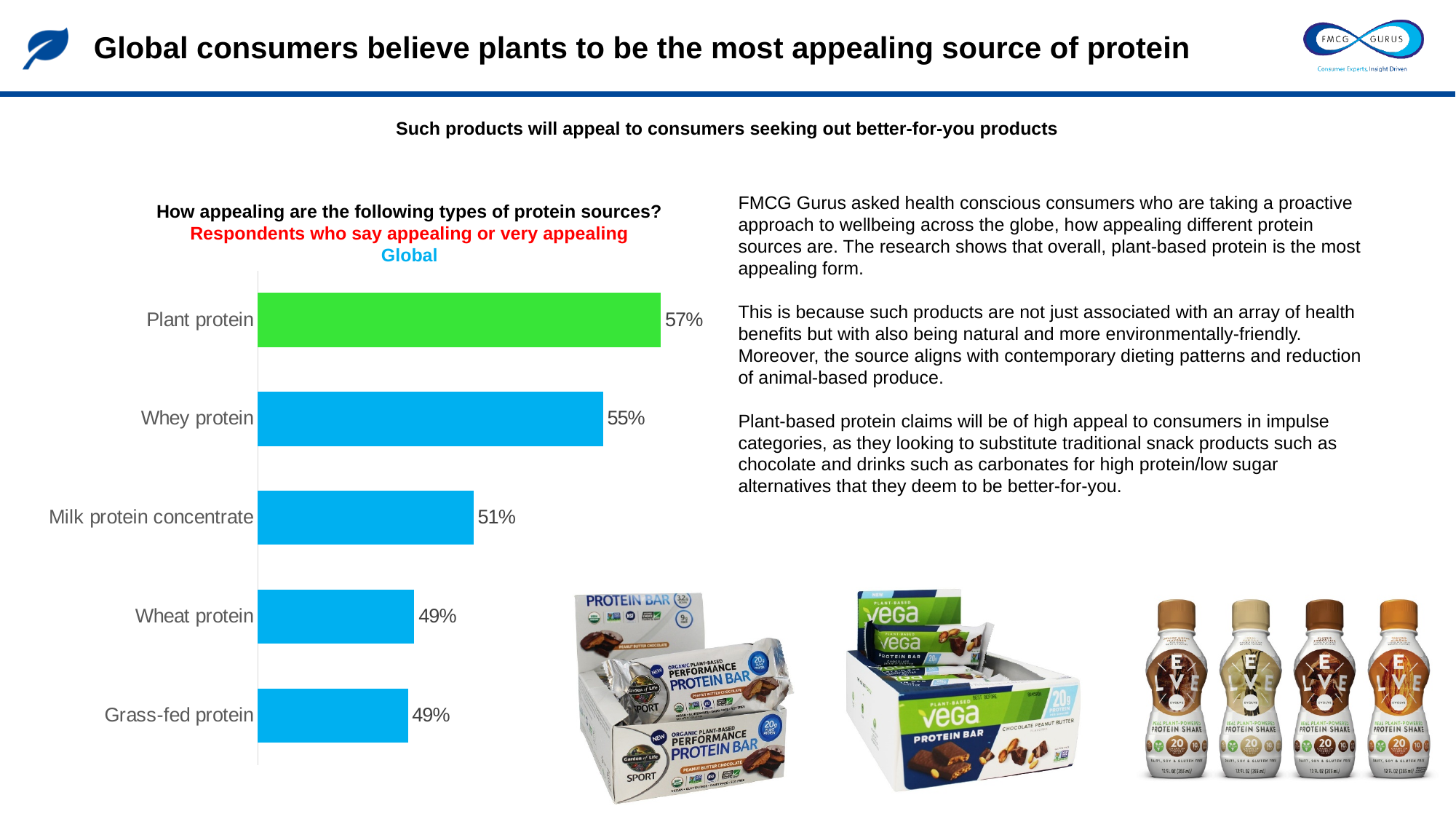
What is the value shown for wheat protein? 49% Which two protein sources share the same value of 49%? Wheat protein and grass-fed protein Which protein source has the highest share of respondents saying appealing or very appealing? Plant protein Which bar in the chart is coloured green rather than blue? Plant protein What percentage of respondents say plant protein is appealing or very appealing? 57% Which has a higher value, whey protein or milk protein concentrate? Whey protein What is the difference in percentage points between plant protein and whey protein? 2 percentage points What type of chart is used to show the appeal of protein sources? Bar chart What is the value shown for whey protein? 55% What is the value shown for milk protein concentrate? 51% What is the difference in percentage points between plant protein and grass-fed protein? 8 percentage points How many protein sources are shown in the chart? 5